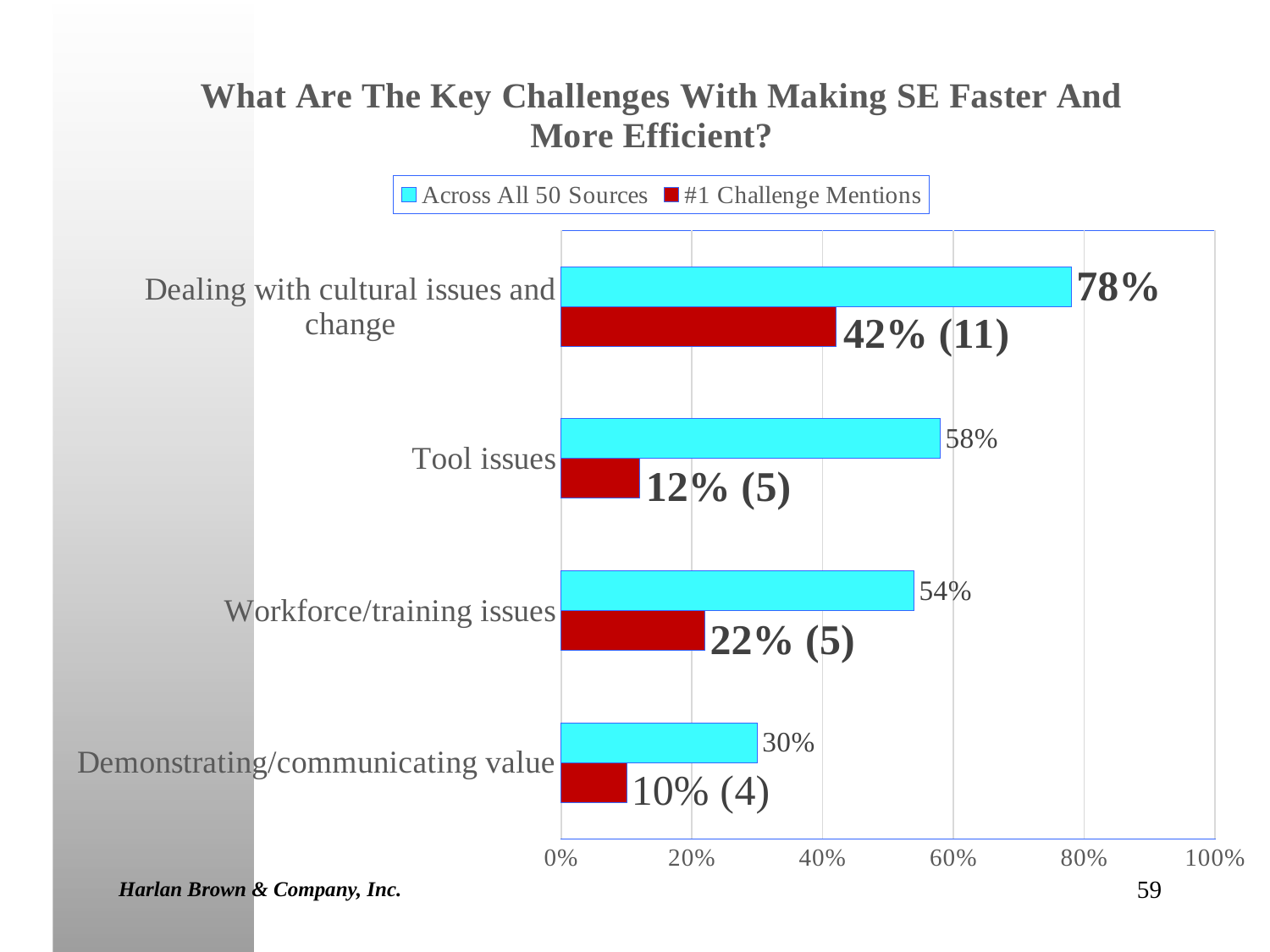
Which category has the lowest value in the #1 Challenge Mentions series? Demonstrating/communicating value Which category has the highest value in the Across All 50 Sources series? Dealing with cultural issues and change What is the data label for Dealing with cultural issues and change in the #1 Challenge Mentions series? 42% (11) What is the difference between the Across All 50 Sources values for Dealing with cultural issues and change and Tool issues? 20% What is the data label for Workforce/training issues in the #1 Challenge Mentions series? 22% (5) What colour are the bars for the #1 Challenge Mentions series? Dark red What kind of chart is shown on the slide? Bar chart What is the value for Demonstrating/communicating value in the Across All 50 Sources series? 30% How many series does the legend list? 2 How many categories are shown on the chart? 4 What is the value for Tool issues in the Across All 50 Sources series? 58% Which is larger: the #1 Challenge Mentions value for Tool issues or for Workforce/training issues? Workforce/training issues